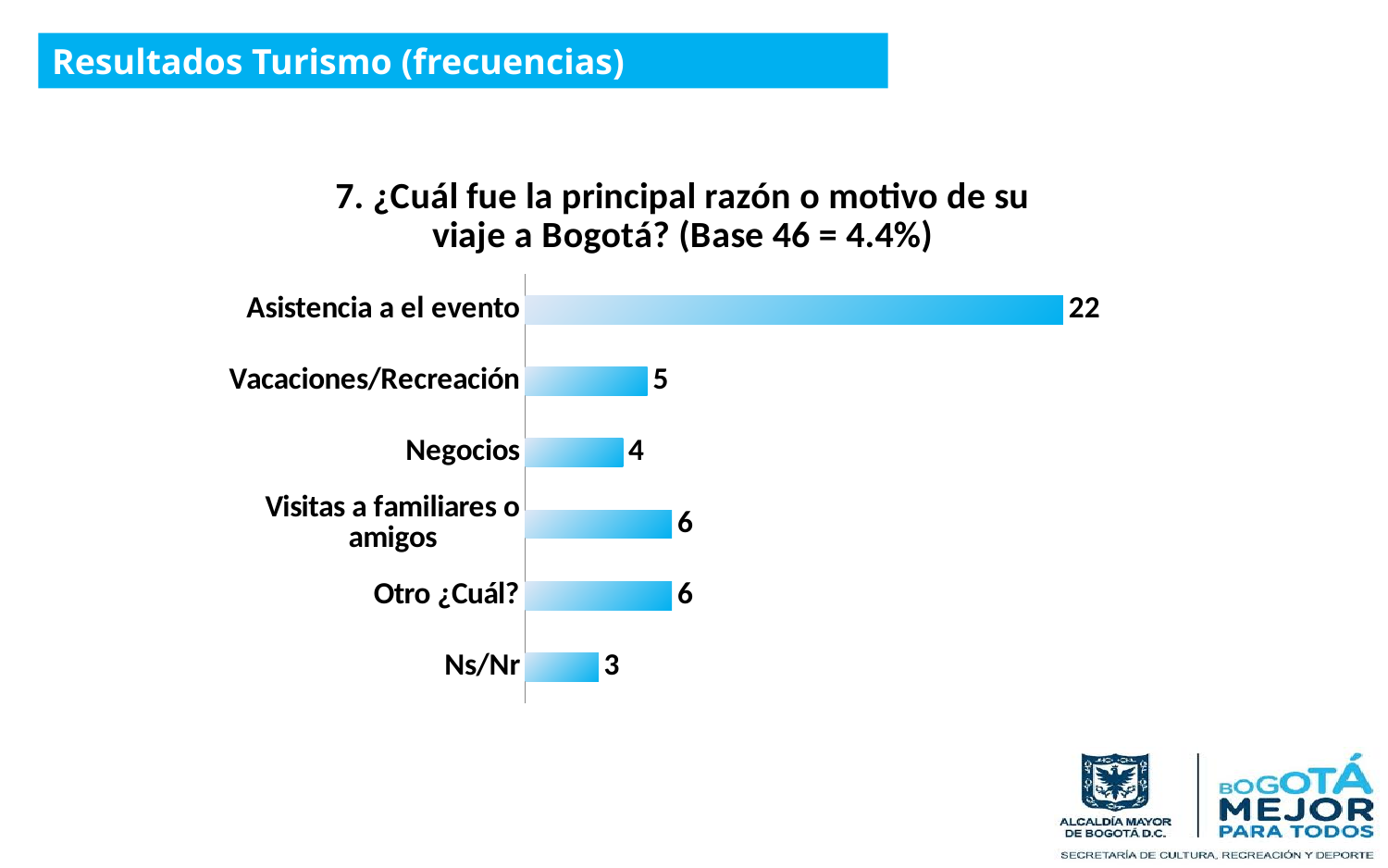
What kind of chart is shown on the slide? Bar chart Which category has the lowest value? Ns/Nr What is the difference between the values for Otro ¿Cuál? and Ns/Nr? 3 What is the value for Negocios? 4 How many categories are shown in the chart? 6 Which category has the highest value? Asistencia a el evento What is the value for Ns/Nr? 3 What is the value for Vacaciones/Recreación? 5 Which is larger, the value for Negocios or the value for Visitas a familiares o amigos? Visitas a familiares o amigos What is the value for Asistencia a el evento? 22 What is the difference between the values for Asistencia a el evento and Vacaciones/Recreación? 17 What base is stated in the chart title? Base 46 = 4.4%